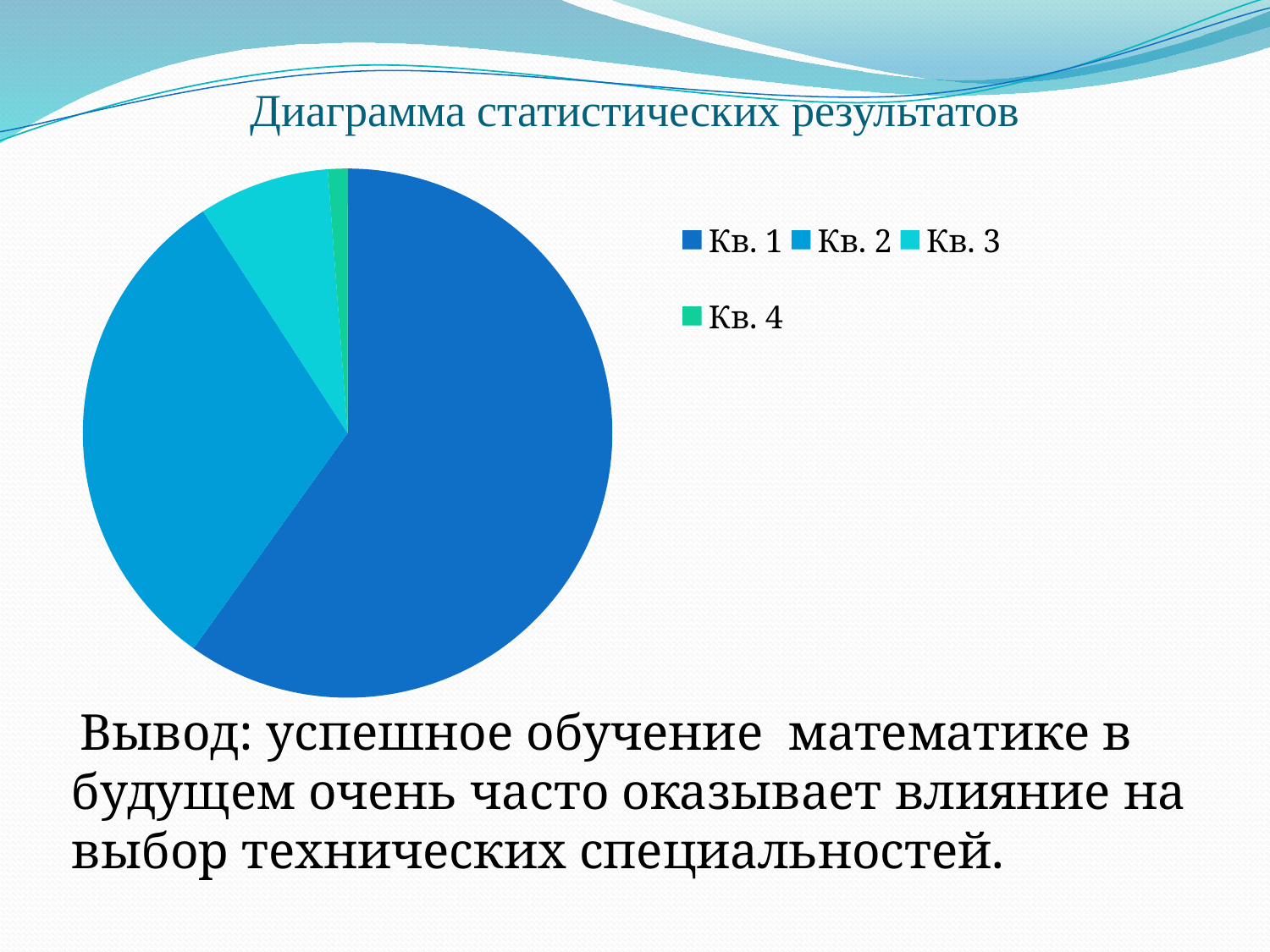
Which category has the smallest slice of the pie? Кв. 4 Which category has the second-largest slice of the pie? Кв. 2 What kind of chart is shown on the slide? pie chart How many slices does the pie chart have? 4 How many entries does the chart legend list? 4 Which slice is larger, Кв. 3 or Кв. 4? Кв. 3 What is the title of the chart? Диаграмма статистических результатов Which legend entry is listed last in the legend? Кв. 4 Which slice is larger, Кв. 1 or Кв. 2? Кв. 1 Which category has the largest slice of the pie? Кв. 1 Which slice is larger, Кв. 2 or Кв. 3? Кв. 2